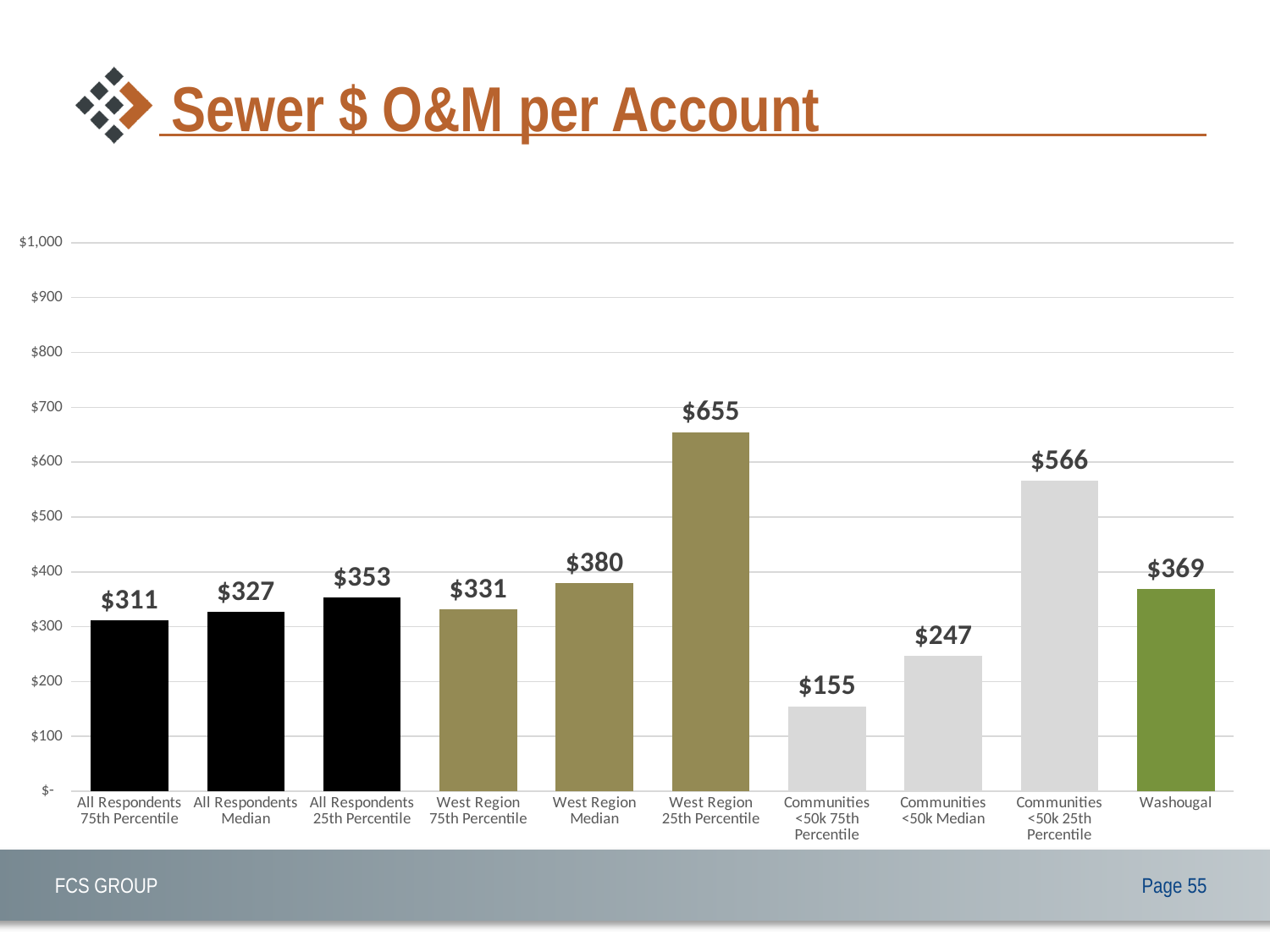
Which category has the highest value? West Region 25th Percentile What kind of chart is shown on the slide? Bar chart What is the difference between Washougal and All Respondents Median? $42 What is the title of the slide? Sewer $ O&M per Account What is the Sewer $ O&M per Account value for Washougal? $369 What is the value for West Region Median? $380 What is the difference between West Region 25th Percentile and Communities <50k 25th Percentile? $89 Is the value for Communities <50k Median greater or less than $300? less Which is larger, All Respondents 25th Percentile or West Region 75th Percentile? All Respondents 25th Percentile How many categories are shown on the x axis? 10 Which category has the lowest value? Communities <50k 75th Percentile What is the value for Communities <50k 75th Percentile? $155